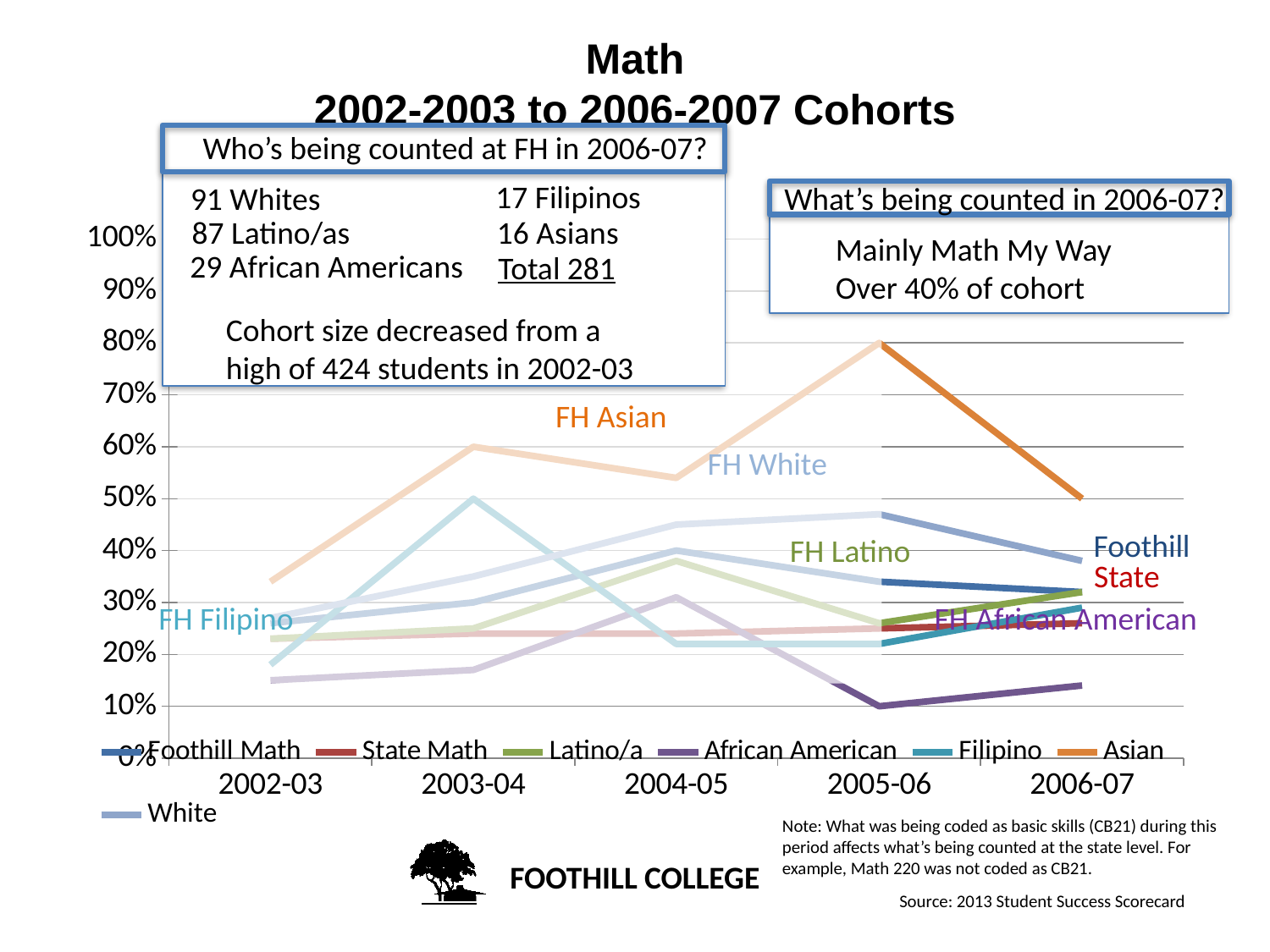
What is the first cohort year shown on the x axis? 2002-03 Is the value for African American in 2005-06 greater or less than 20%? less Which series has the highest value in 2005-06? Asian In which cohort year does the Asian series reach its highest value? 2005-06 How many series does the legend list? 7 What kind of chart is shown on the slide? line chart How many cohort years are plotted along the x axis? 5 Is the value for White in 2006-07 greater or less than 30%? greater Which series has the lowest value in 2005-06? African American Is the value for Asian in 2005-06 greater or less than 70%? greater Does the Asian series rise or fall from 2005-06 to 2006-07? fall In 2003-04, which is larger: the Filipino value or the White value? Filipino